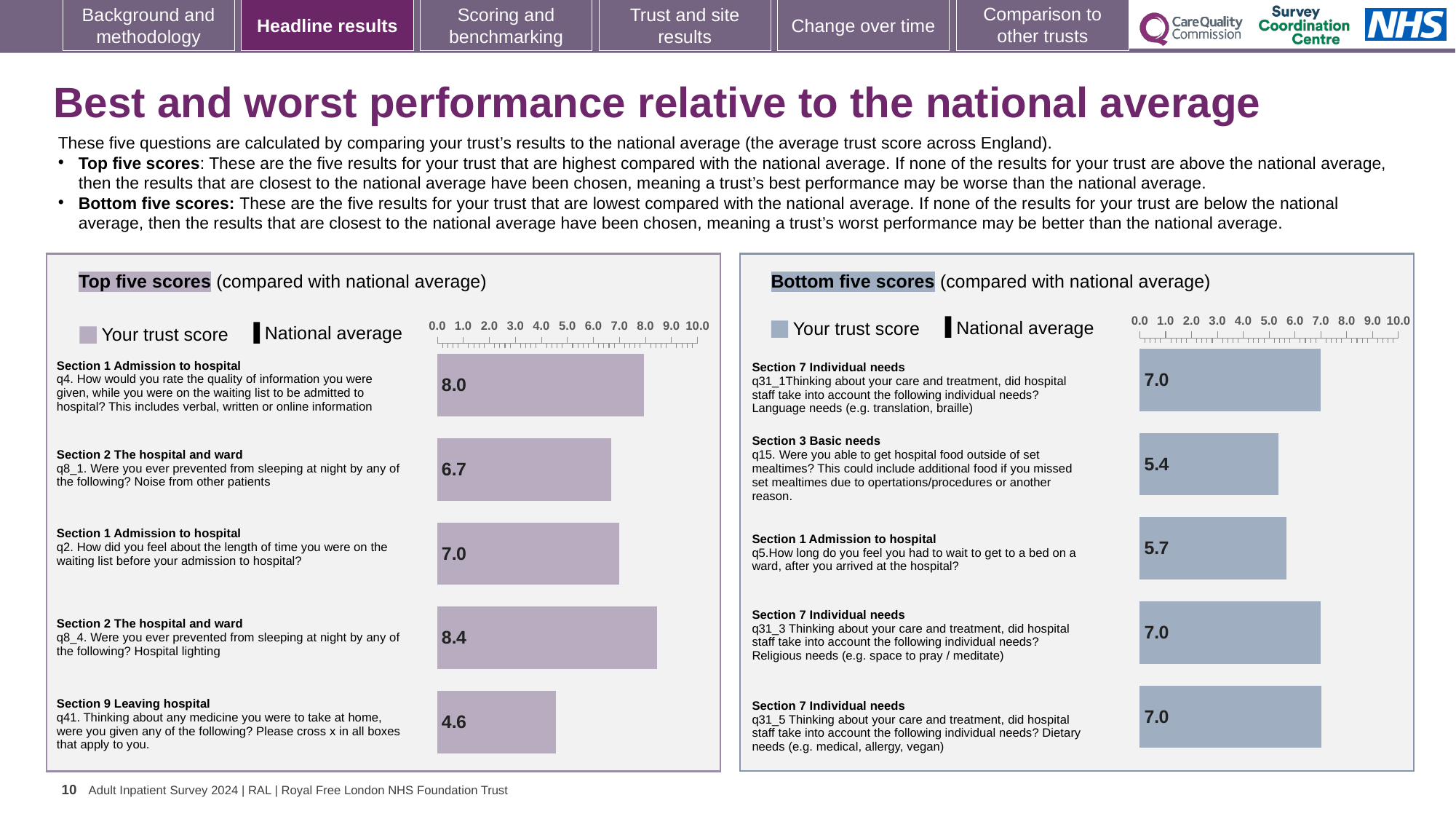
How many series does the legend of the Top five scores chart list? 2 How many questions are shown in the Bottom five scores chart? 5 In the Top five scores chart, what is the trust score for q41 (medicine to take at home)? 4.6 In the Bottom five scores chart, what is the trust score for q15 (hospital food outside of set mealtimes)? 5.4 In the Top five scores chart, what is the trust score for q4 (quality of information given while on the waiting list)? 8.0 In the Top five scores chart, which has the larger trust score: q8_1 (noise from other patients) or q2 (length of time on the waiting list)? q2 In the Top five scores chart, which question has the highest trust score? q8_4 (Hospital lighting) What type of chart is used for the Top five scores? Bar chart In the Top five scores chart, what is the difference between the trust scores for q8_4 and q41? 3.8 In the Bottom five scores chart, what is the difference between the trust scores for q5 and q15? 0.3 In the Bottom five scores chart, what is the trust score for q5 (wait to get to a bed on a ward)? 5.7 In the Bottom five scores chart, which question has the lowest trust score? q15 (hospital food outside of set mealtimes)